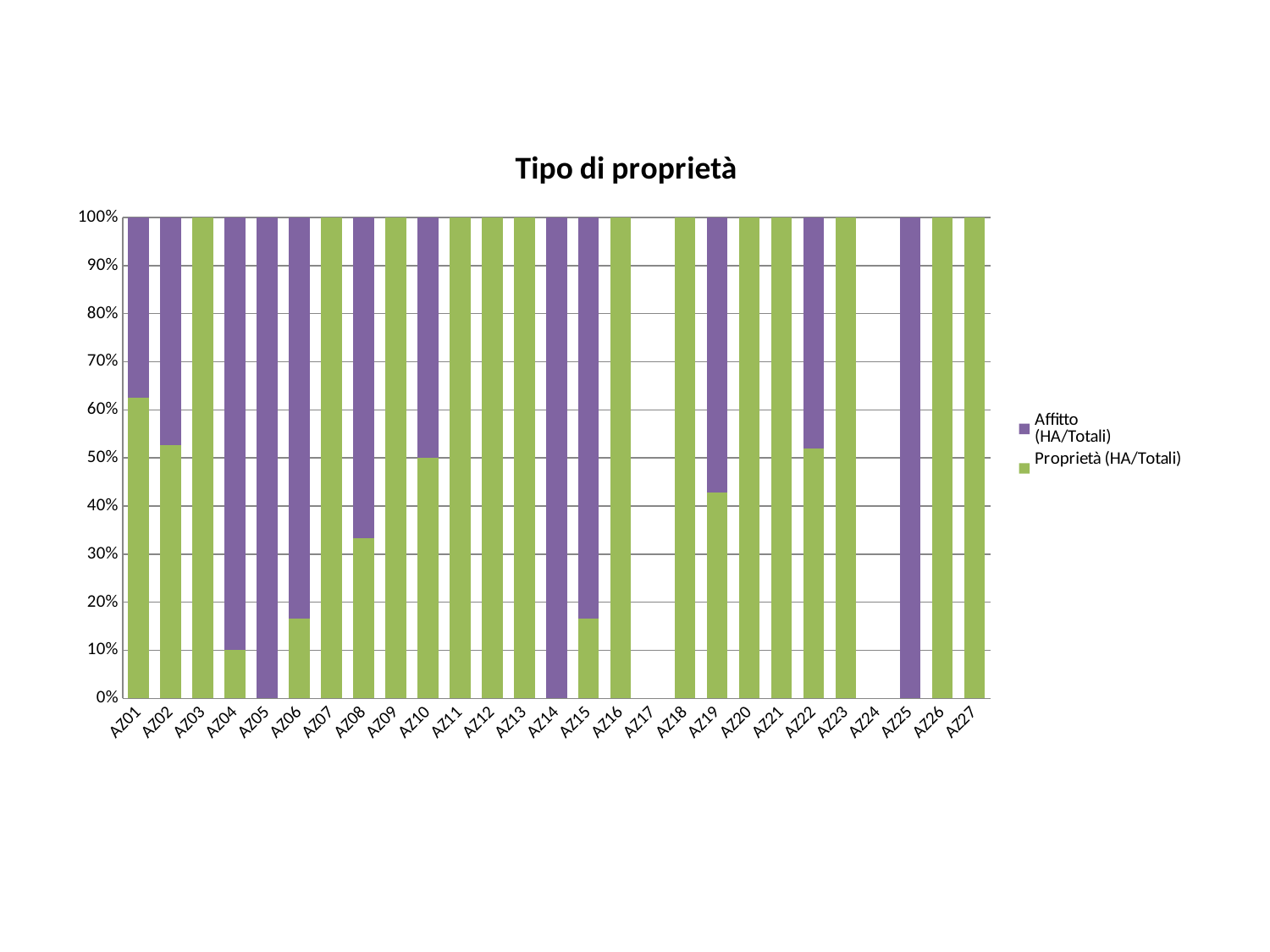
Is the Proprietà (HA/Totali) value for AZ04 greater or less than 20%? less Which colour represents the Affitto (HA/Totali) series? Purple Is the Proprietà (HA/Totali) value for AZ06 greater or less than 20%? less How many series does the legend list? 2 What is the Affitto (HA/Totali) value for AZ05? 100% What kind of chart is shown on the slide? Stacked bar chart Is the Proprietà (HA/Totali) value for AZ01 greater or less than 60%? greater How many categories are shown on the x axis? 27 Which has the larger Proprietà (HA/Totali) share, AZ15 or AZ22? AZ22 Which has the larger Proprietà (HA/Totali) share, AZ01 or AZ02? AZ01 What is the title of the chart? Tipo di proprietà